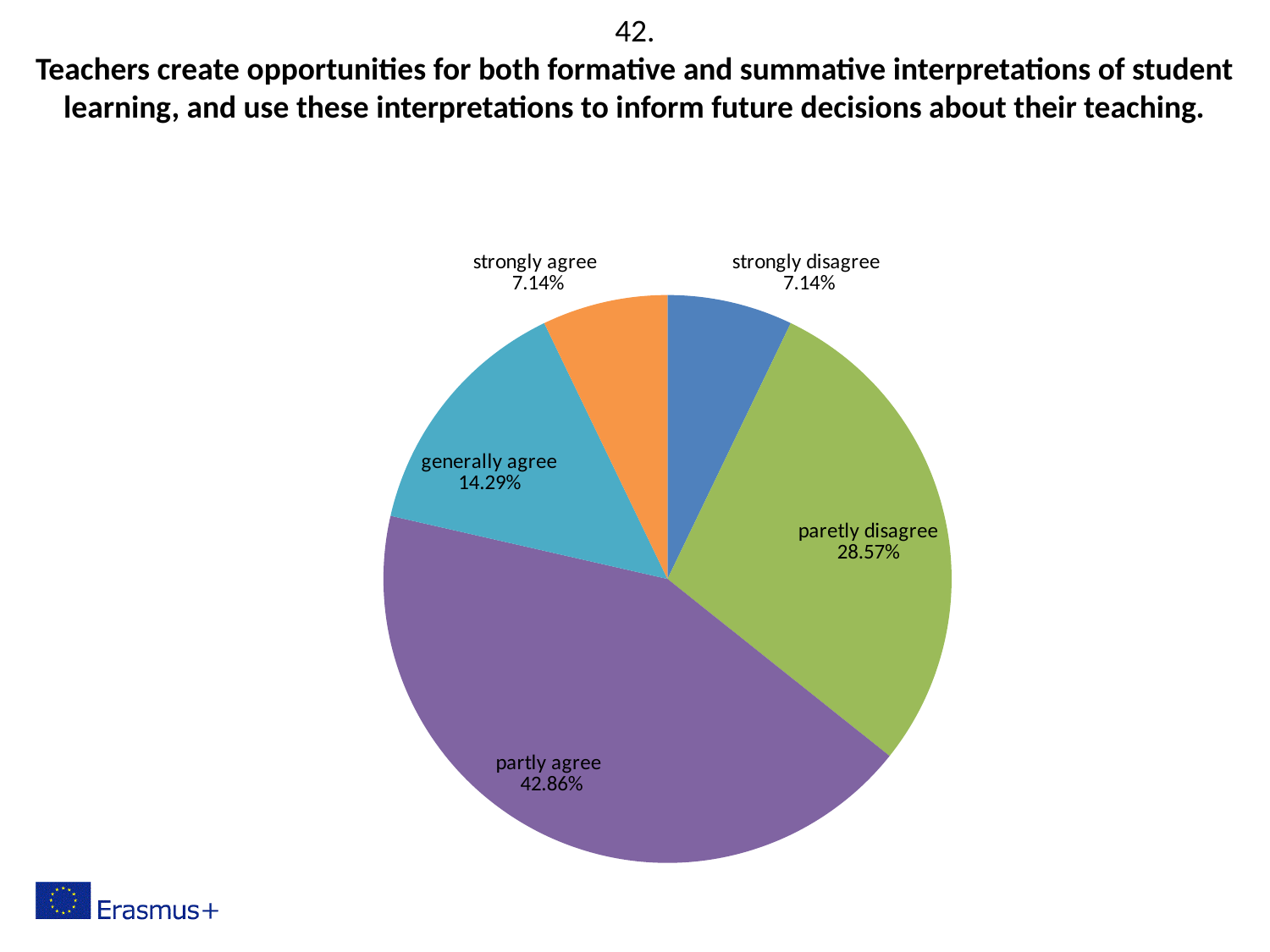
Which two response categories share the same percentage of 7.14%? strongly agree and strongly disagree How many slices does the pie chart have? 5 What kind of chart is shown on the slide? pie chart What percentage of respondents chose 'partly agree'? 42.86% What percentage of respondents chose 'strongly agree'? 7.14% What is the difference in percentage points between 'partly agree' and 'paretly disagree'? 14.29 Which response category has the largest share of the pie? partly agree What colour is the 'partly agree' slice? purple What is the difference in percentage points between 'generally agree' and 'strongly agree'? 7.15 What percentage of respondents chose 'generally agree'? 14.29% What percentage of respondents chose 'paretly disagree'? 28.57% Which is larger, the share for 'paretly disagree' or the share for 'generally agree'? paretly disagree